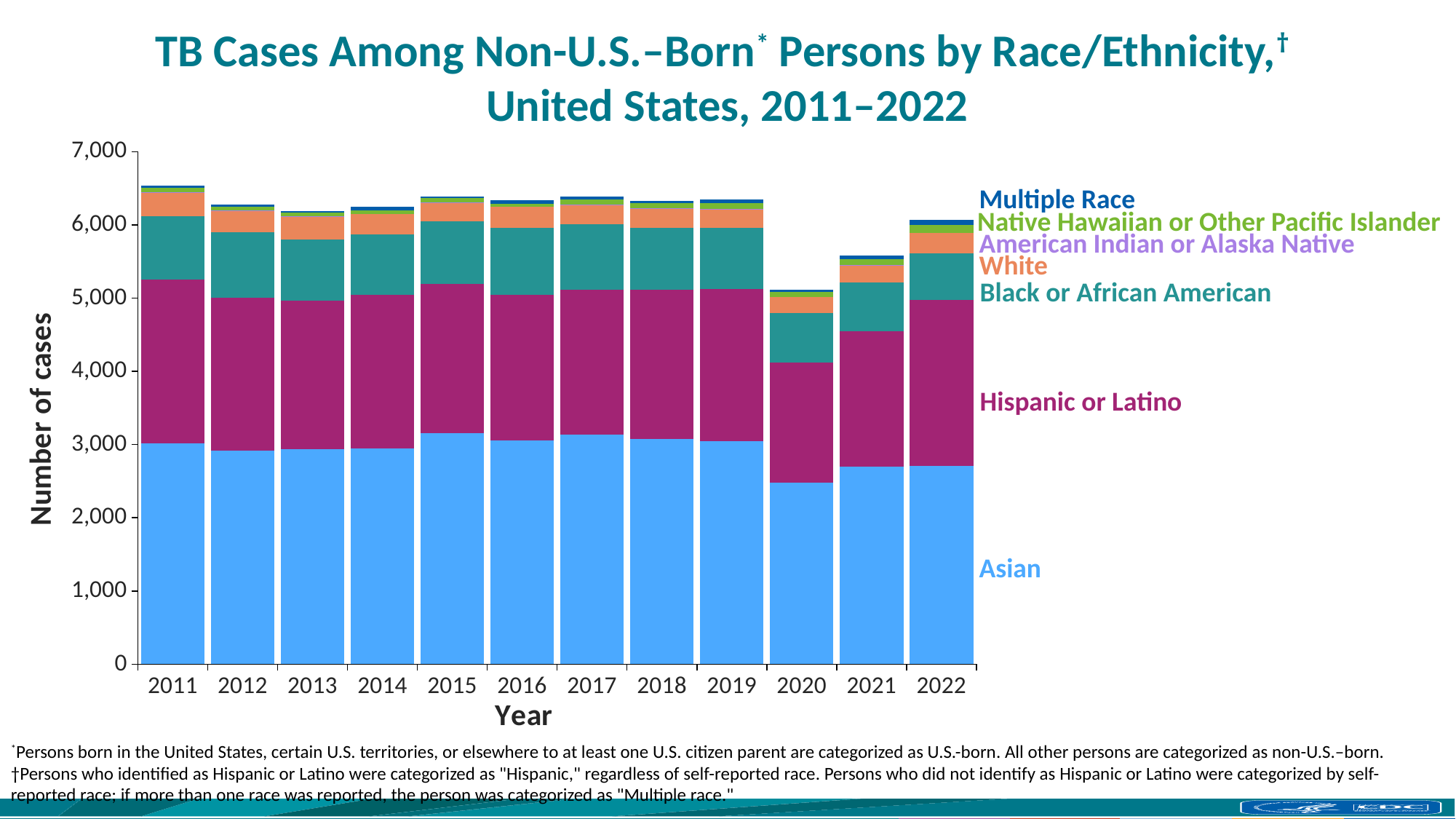
Which year has the larger total number of cases, 2019 or 2020? 2019 Which year has the lowest total number of TB cases among non-U.S.-born persons? 2020 Is the total number of cases in 2020 greater or less than 6,000? less Is the number of cases among Asian persons in 2020 greater or less than 3,000? less Which race/ethnicity group forms the bottom segment of each bar? Asian What kind of chart is shown on the slide? Stacked bar chart How many years are shown along the x axis? 12 Does the total number of cases rise or fall from 2019 to 2020? fall Is the total number of cases in 2011 greater or less than 6,000? greater How many race/ethnicity series does the legend list? 7 Which year has the highest total number of TB cases among non-U.S.-born persons? 2011